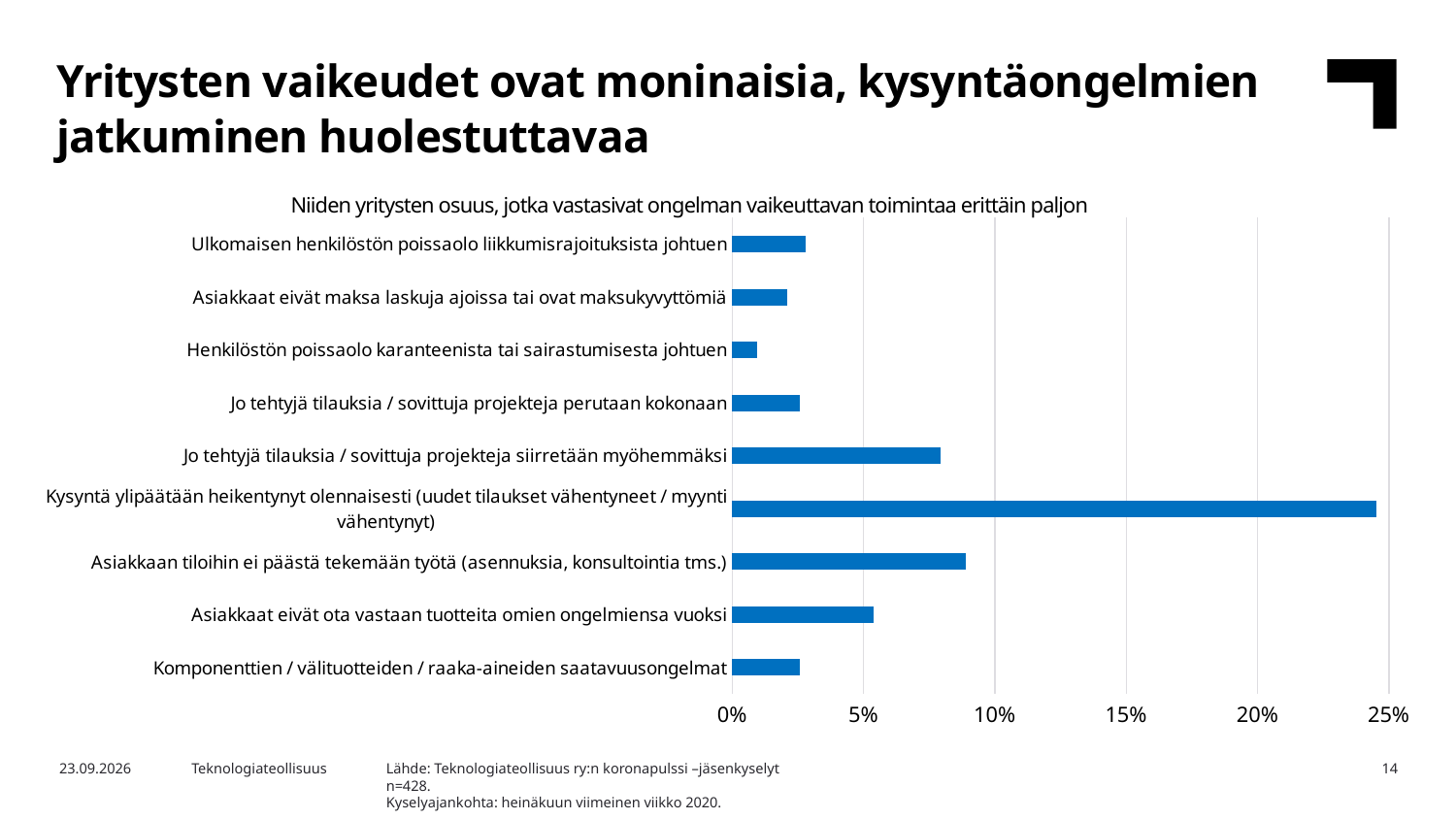
What kind of chart is shown on the slide? Bar chart Is the value for 'Kysyntä ylipäätään heikentynyt olennaisesti' greater or less than 20%? greater Which category has the lowest value in the chart? Henkilöstön poissaolo karanteenista tai sairastumisesta johtuen Which category has the highest value in the chart? Kysyntä ylipäätään heikentynyt olennaisesti (uudet tilaukset vähentyneet / myynti vähentynyt) Is the value for 'Asiakkaan tiloihin ei päästä tekemään työtä' greater or less than 10%? less What is the highest value shown on the chart's horizontal axis? 25% Which is larger: the value for 'Asiakkaan tiloihin ei päästä tekemään työtä' or for 'Asiakkaat eivät ota vastaan tuotteita omien ongelmiensa vuoksi'? Asiakkaan tiloihin ei päästä tekemään työtä Is the value for 'Henkilöstön poissaolo karanteenista tai sairastumisesta johtuen' greater or less than 5%? less How many categories are plotted in the chart? 9 Which is larger: the value for 'Ulkomaisen henkilöstön poissaolo liikkumisrajoituksista johtuen' or for 'Henkilöstön poissaolo karanteenista tai sairastumisesta johtuen'? Ulkomaisen henkilöstön poissaolo liikkumisrajoituksista johtuen What is the title of the chart? Niiden yritysten osuus, jotka vastasivat ongelman vaikeuttavan toimintaa erittäin paljon